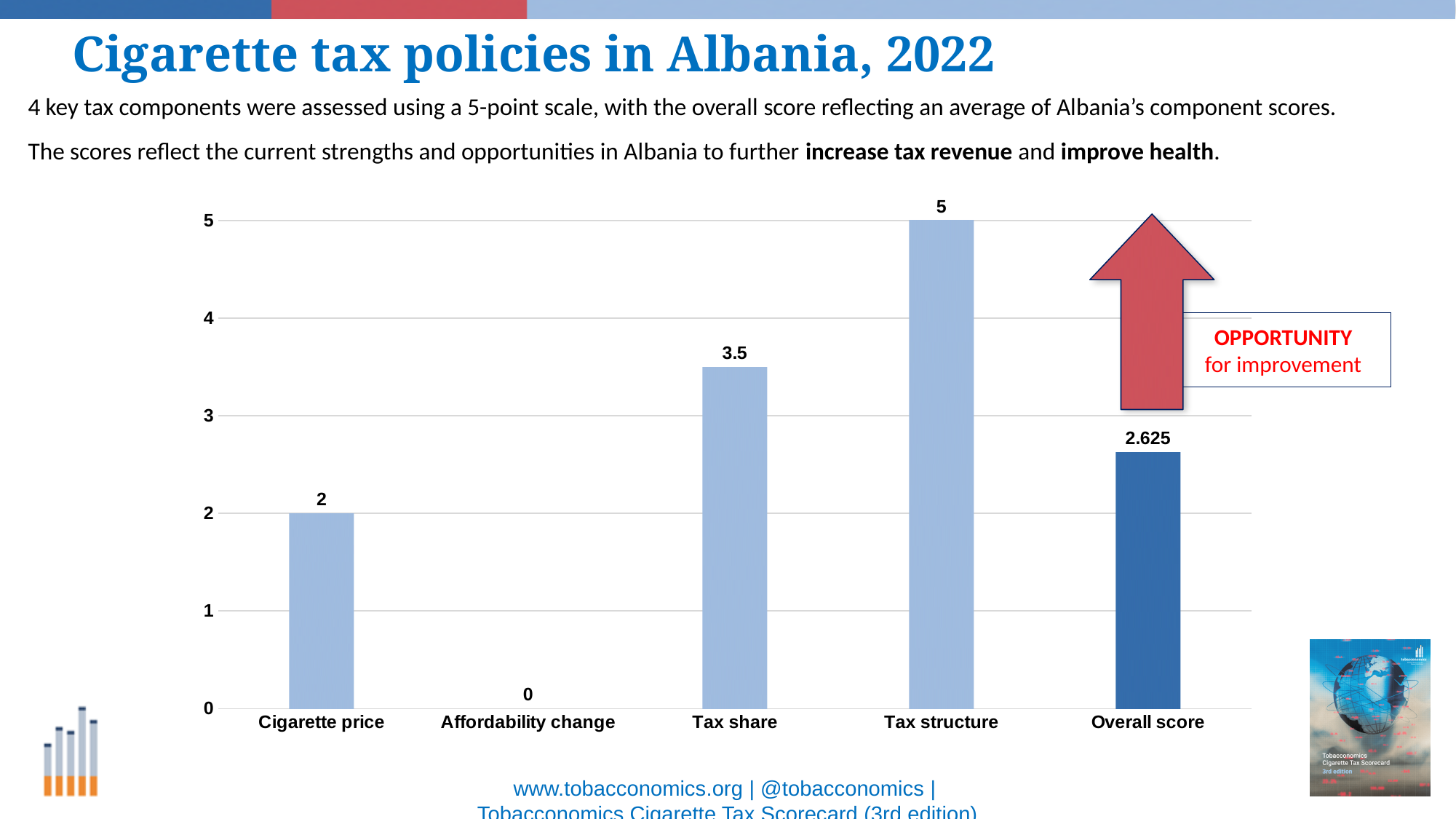
What is the value for Tax share? 3.5 Which category has the lowest value? Affordability change Which is larger, the value for Cigarette price or the value for Overall score? Overall score Which category has the highest value? Tax structure What kind of chart is shown on the slide? Bar chart What is the value for Overall score? 2.625 What text is shown in the red box next to the arrow on the chart? OPPORTUNITY for improvement How many categories are shown on the x axis? 5 What is the difference between the values for Tax share and Cigarette price? 1.5 What is the value for Affordability change? 0 What is the difference between the values for Tax structure and Tax share? 1.5 What is the value for Cigarette price? 2